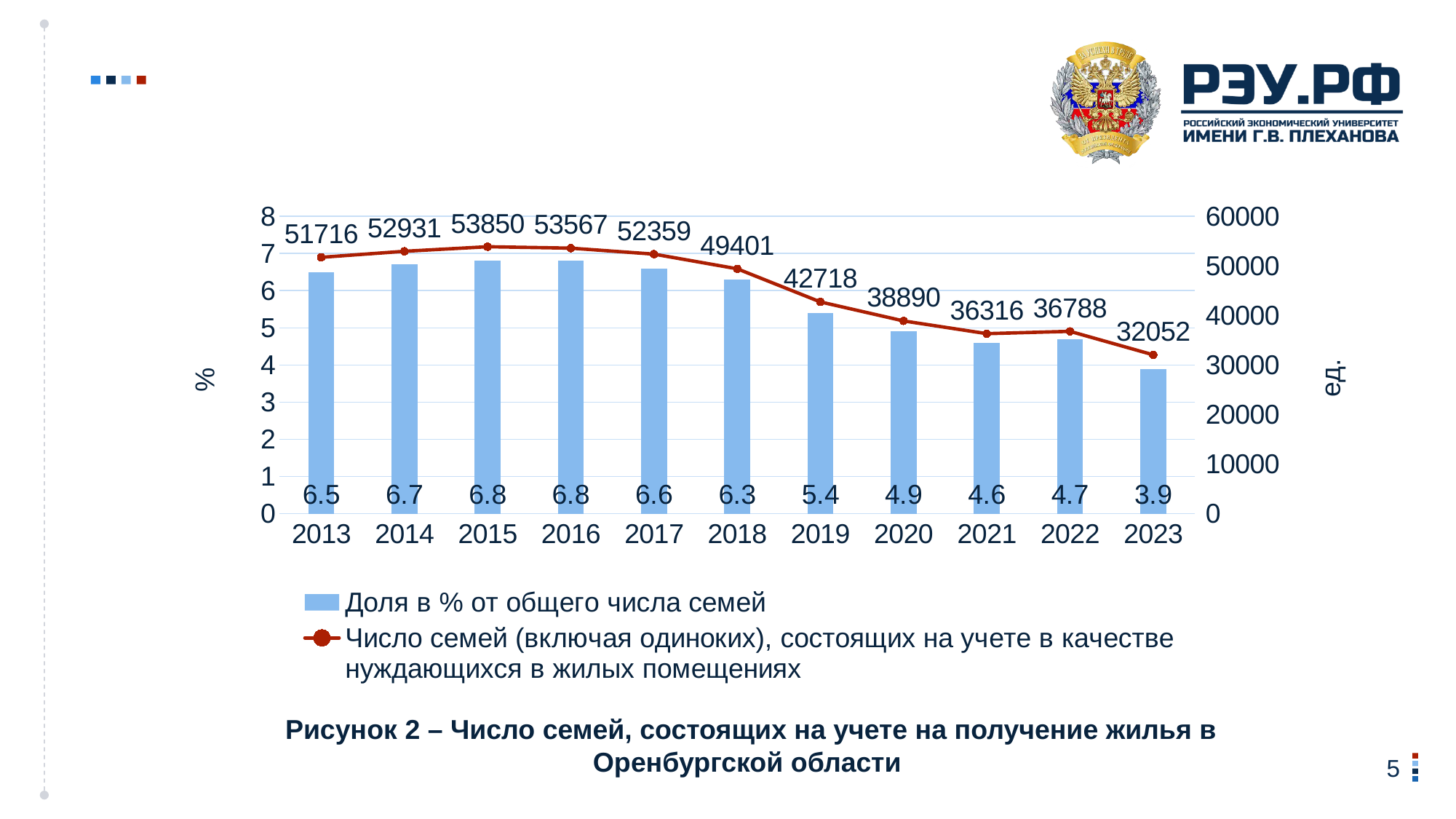
What kind of chart is this? Combined bar and line chart How many years are shown on the x axis? 11 How many series does the legend list? 2 What is the difference between the number of families in 2013 and in 2023? 19664 Which year has a larger share in %: 2018 or 2019? 2018 In which year is the share in % (bar series) lowest? 2023 What is the value of the line series (Число семей) for 2020? 38890 In which year is the number of families (line series) highest? 2015 What is the share in % (Доля в % от общего числа семей) for 2023? 3.9 Does the number of families (line series) rise or fall from 2016 to 2023? Fall What is the label of the right-hand vertical axis? ед. What is the value of the line series (Число семей) for 2015? 53850